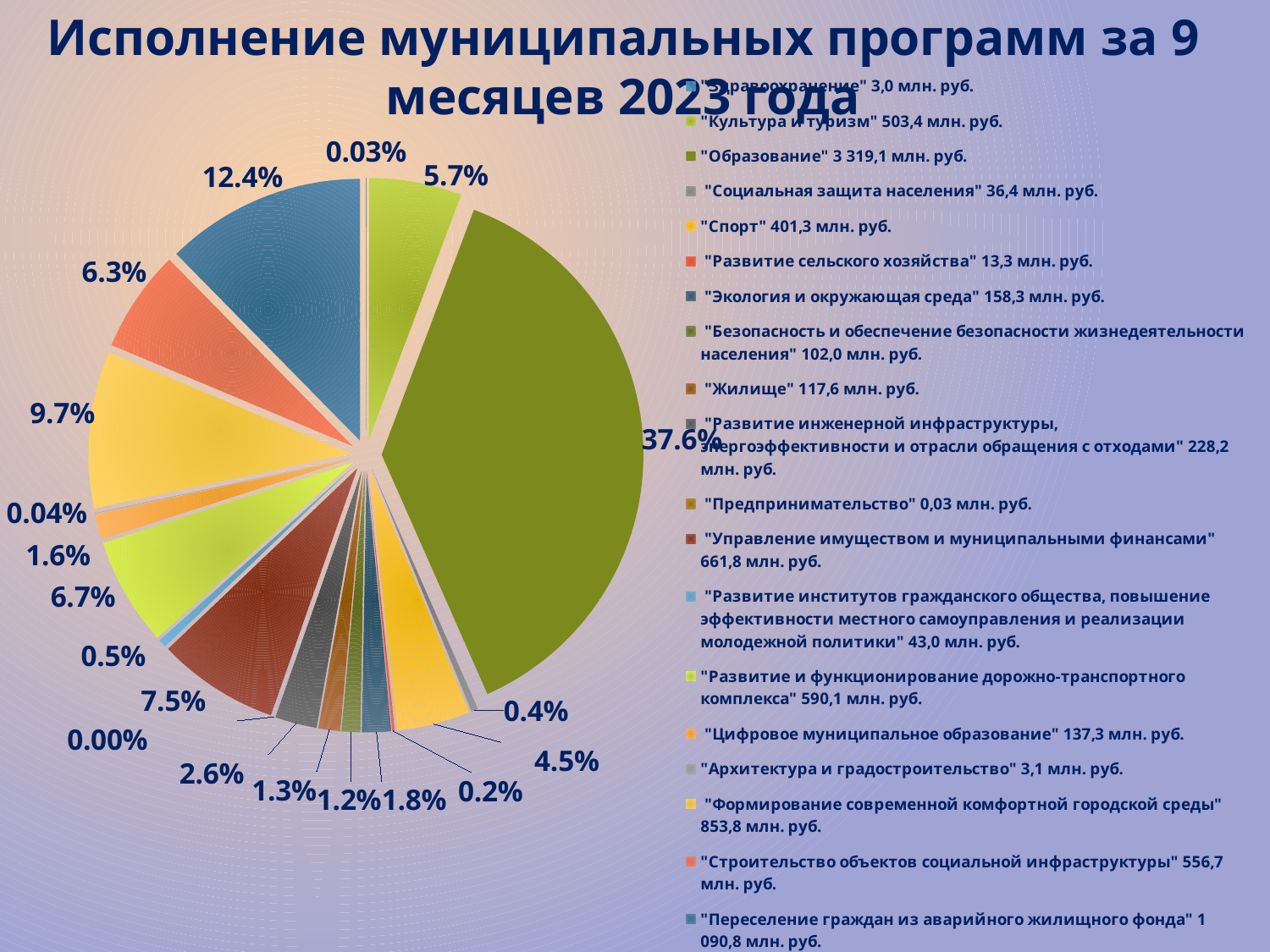
What is the difference between the values for "Образование" and "Переселение граждан из аварийного жилищного фонда"? 2 228,3 млн. руб. How many programme categories does the legend list? 19 What share of the pie does the largest slice, "Образование", take? 37.6% What is the value for "Переселение граждан из аварийного жилищного фонда"? 1 090,8 млн. руб. What is the value for "Предпринимательство"? 0,03 млн. руб. Which is larger, the value for "Культура и туризм" or for "Спорт"? "Культура и туризм" What is the title of the chart? Исполнение муниципальных программ за 9 месяцев 2023 года What is the value for "Спорт"? 401,3 млн. руб. Which programme has the largest value? "Образование" What is the value for "Образование" in the legend? 3 319,1 млн. руб. What kind of chart is shown on the slide? pie chart Which programme has the smallest value? "Предпринимательство"